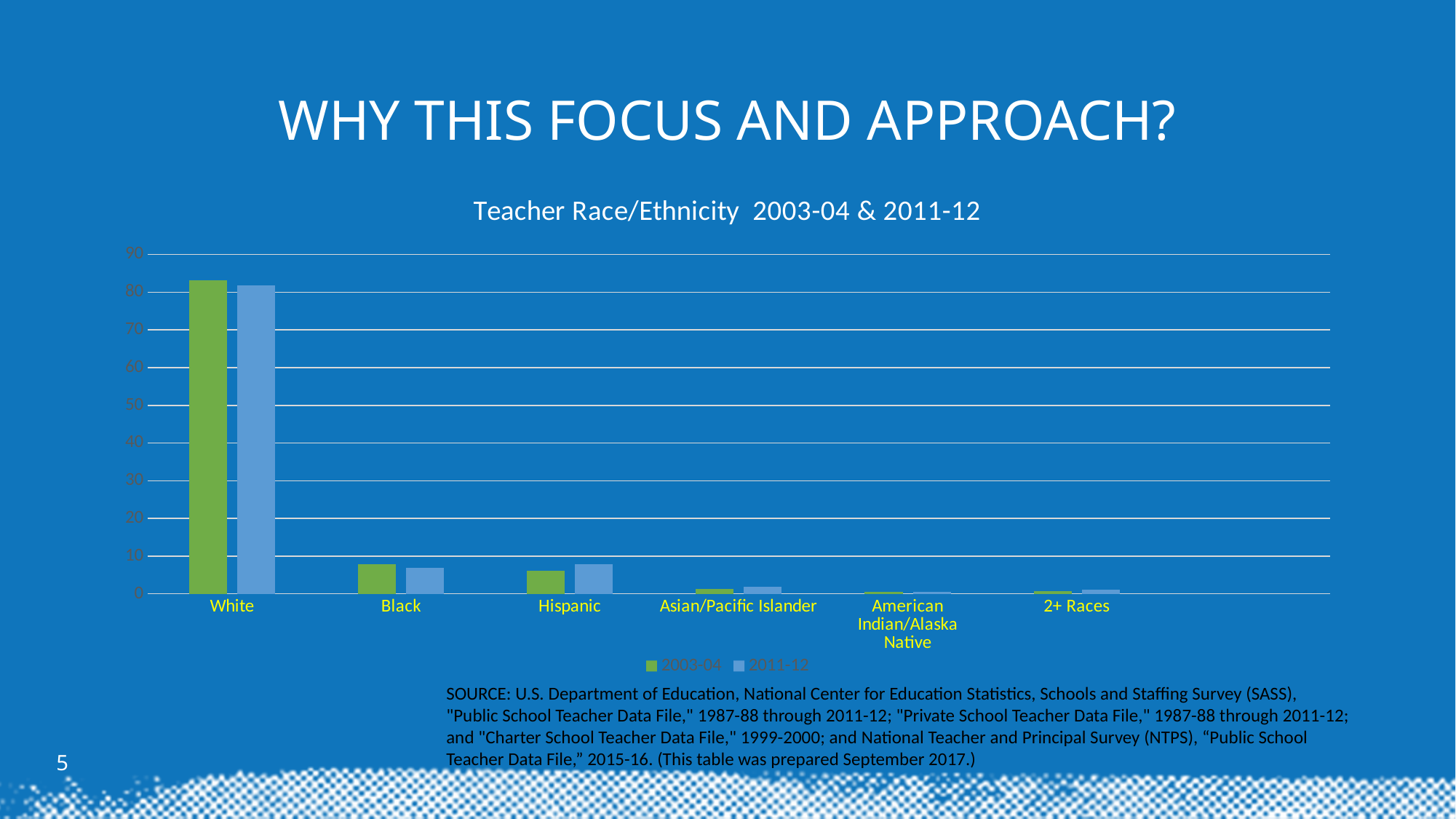
Which category has the highest value for 2003-04? White How many series does the legend list? 2 What is the title of the chart? Teacher Race/Ethnicity 2003-04 & 2011-12 Which is larger for Hispanic: the 2003-04 value or the 2011-12 value? 2011-12 What kind of chart is shown on the slide? bar chart Is the value for White in 2003-04 greater or less than 80? greater Which category has the highest value for 2011-12? White Is the value for Hispanic in 2003-04 greater or less than 10? less Is the value for Black in 2011-12 greater or less than 10? less Which colour represents the 2003-04 series? green How many race/ethnicity categories are shown on the x axis? 6 Which is larger in 2003-04: White or Black? White